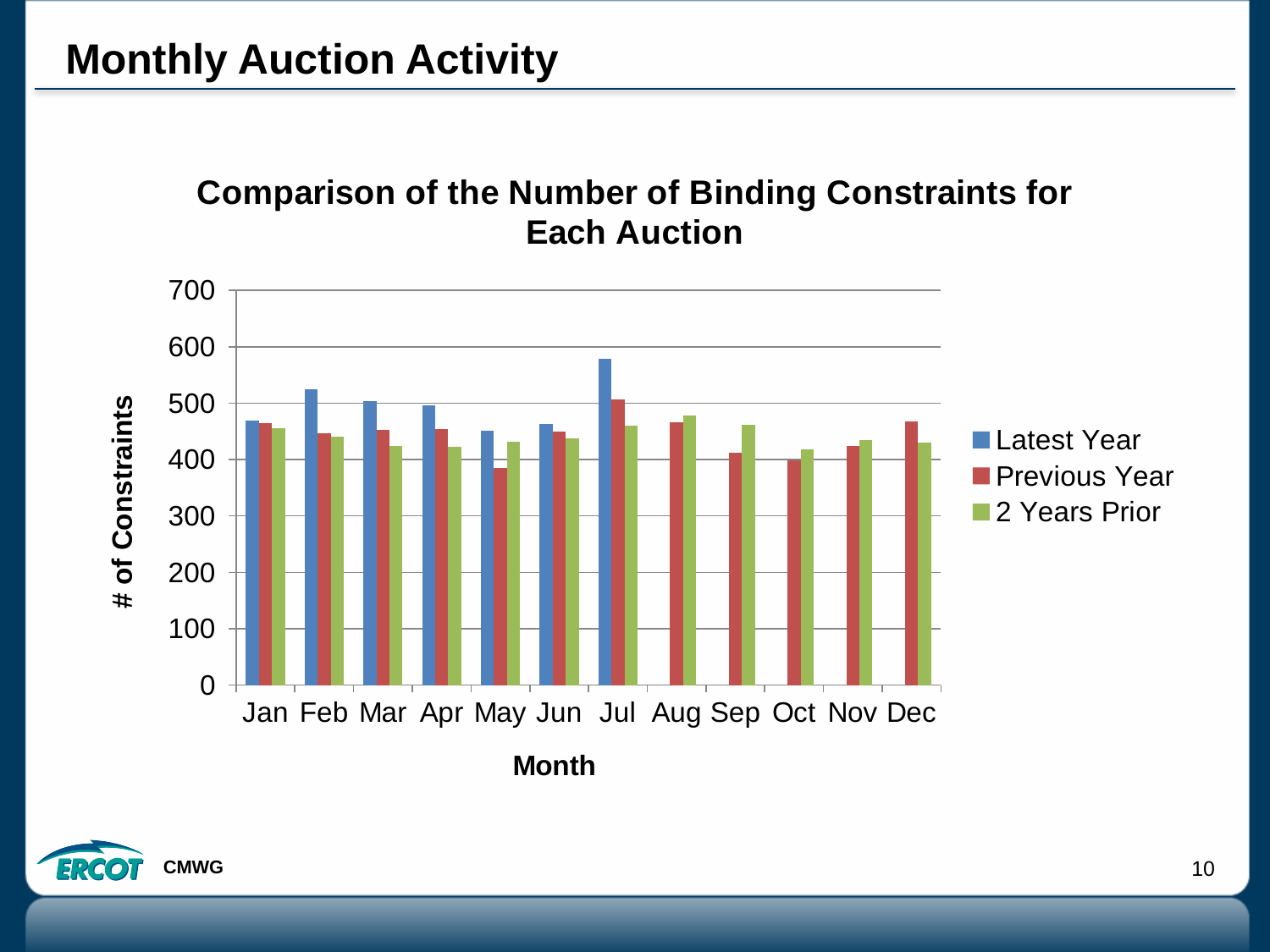
Is the Previous Year value for May greater or less than 400? less In which month is the Previous Year value lowest? May How many series does the legend list? 3 How many months are shown on the x axis? 12 Is the 2 Years Prior value for Aug greater or less than 450? greater In which month is the Previous Year value highest? Jul Is the Latest Year value for Jul greater or less than 500? greater What kind of chart is shown on the slide? Bar chart For Jul, which is larger: the Latest Year value or the Previous Year value? Latest Year What is the title of the vertical axis? # of Constraints In which month is the Latest Year value highest? Jul For May, which is larger: the Previous Year value or the 2 Years Prior value? 2 Years Prior